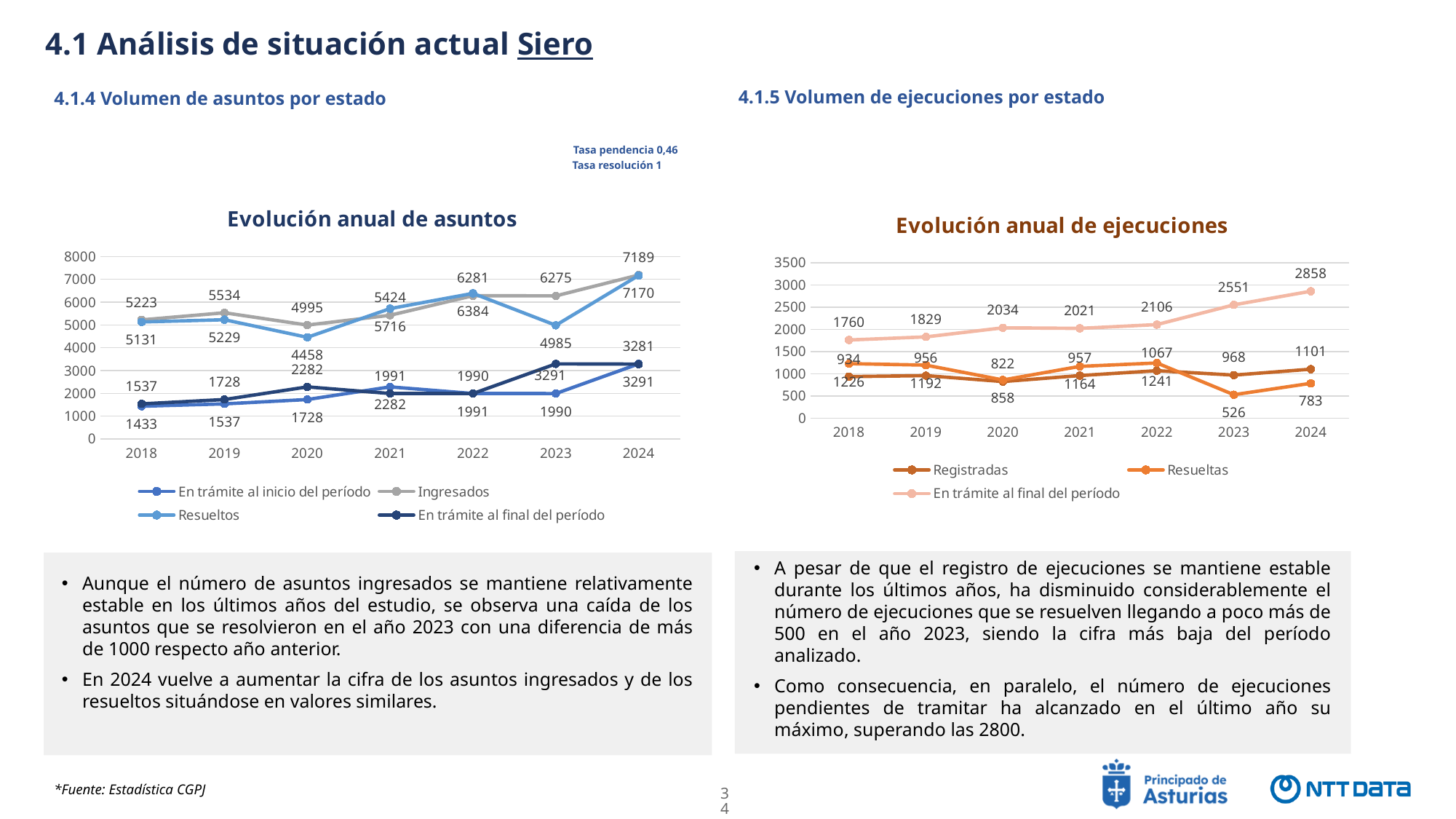
In the 'Evolución anual de ejecuciones' chart, what is the value of 'En trámite al final del período' in 2024? 2858 In the 'Evolución anual de asuntos' chart, what is the value of Resueltos in 2023? 4985 In the 'Evolución anual de ejecuciones' chart, what is the value of Resueltas in 2023? 526 In the 'Evolución anual de asuntos' chart, what is the value of Ingresados in 2019? 5534 What type of chart is 'Evolución anual de ejecuciones'? line chart In the 'Evolución anual de asuntos' chart, what is the value of 'En trámite al final del período' in 2023? 3291 In the 'Evolución anual de ejecuciones' chart, does 'En trámite al final del período' rise or fall from 2022 to 2024? rise In the 'Evolución anual de asuntos' chart, how many series does the legend list? 4 How many years are shown on the x axis of the 'Evolución anual de ejecuciones' chart? 7 In the 'Evolución anual de ejecuciones' chart, which year has the highest value for Registradas? 2024 In the 'Evolución anual de asuntos' chart, which year has the lowest value for Ingresados? 2020 In the 'Evolución anual de asuntos' chart, what is the difference between Ingresados and Resueltos in 2023? 1290